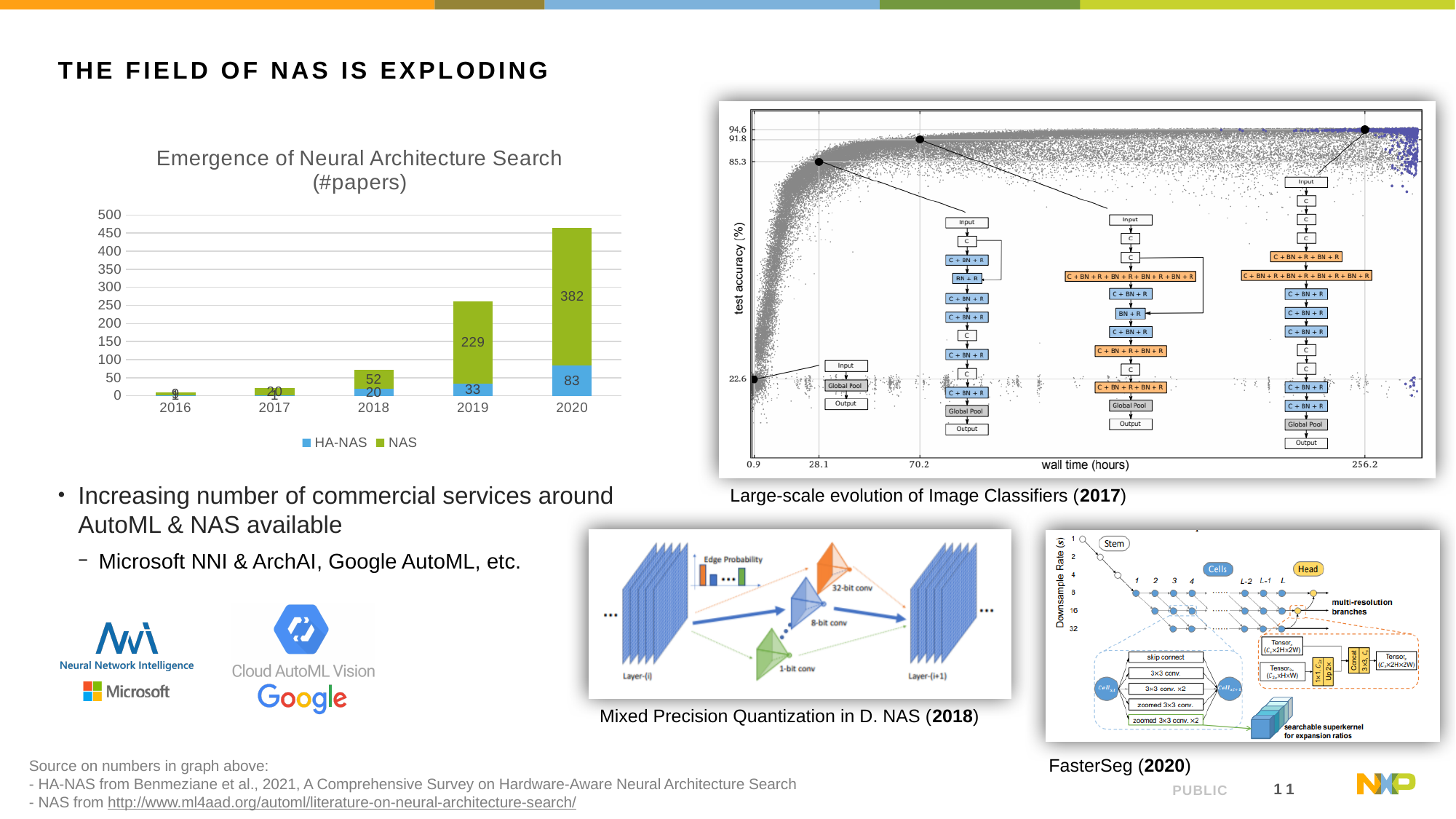
In the 'Emergence of Neural Architecture Search (#papers)' chart, what is the total of the stacked bar for 2020? 465 In the 'Emergence of Neural Architecture Search (#papers)' chart, what is the NAS value for 2020? 382 In the 'Emergence of Neural Architecture Search (#papers)' chart, which year has the highest NAS value? 2020 In the 'Emergence of Neural Architecture Search (#papers)' chart, what is the total of the stacked bar for 2019? 262 In the 'Emergence of Neural Architecture Search (#papers)' chart, which is larger: the NAS value for 2019 or the HA-NAS value for 2020? NAS value for 2019 In the 'Emergence of Neural Architecture Search (#papers)' chart, what is the HA-NAS value for 2019? 33 In the 'Emergence of Neural Architecture Search (#papers)' chart, what is the difference between the NAS values for 2020 and 2019? 153 In the 'Emergence of Neural Architecture Search (#papers)' chart, do the NAS values rise or fall from 2016 to 2020? rise In the 'Emergence of Neural Architecture Search (#papers)' chart, what is the HA-NAS value for 2020? 83 In the 'Emergence of Neural Architecture Search (#papers)' chart, how many series does the legend list? 2 In the 'Emergence of Neural Architecture Search (#papers)' chart, what is the NAS value for 2018? 52 In the 'Emergence of Neural Architecture Search (#papers)' chart, how many years are shown on the x axis? 5